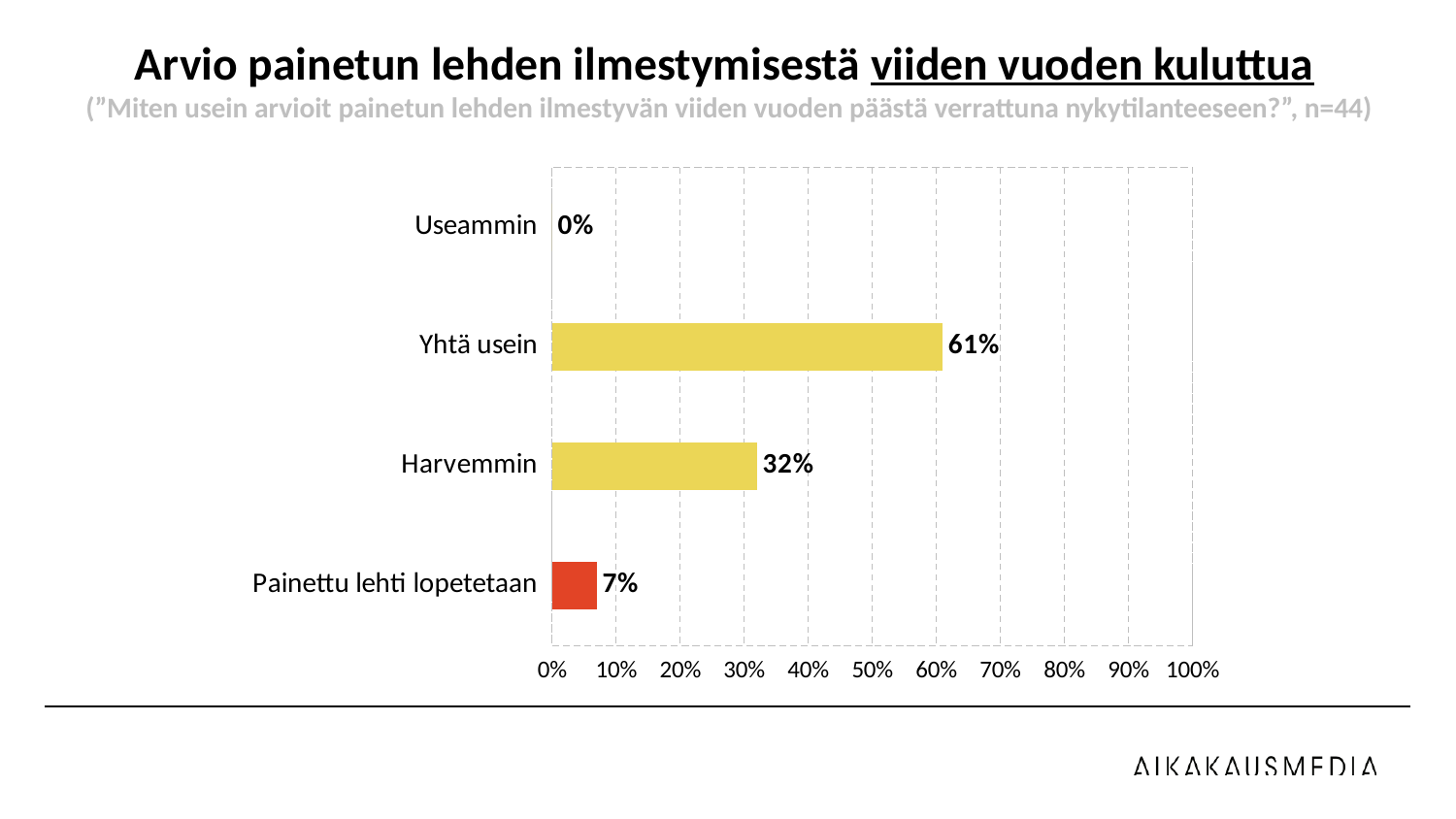
What is the value for Painettu lehti lopetetaan? 7% What is the value for Useammin? 0% What is the difference between the values for Yhtä usein and Harvemmin? 29% How many categories are shown in the chart? 4 What kind of chart is shown on the slide? Bar chart What is the value for Yhtä usein? 61% Which category has the lowest value? Useammin Which category has the highest value? Yhtä usein What is the sample size (n) stated in the subtitle? n=44 Which is larger, the value for Harvemmin or the value for Painettu lehti lopetetaan? Harvemmin What is the value for Harvemmin? 32% Is the value for Yhtä usein greater or less than 50%? greater